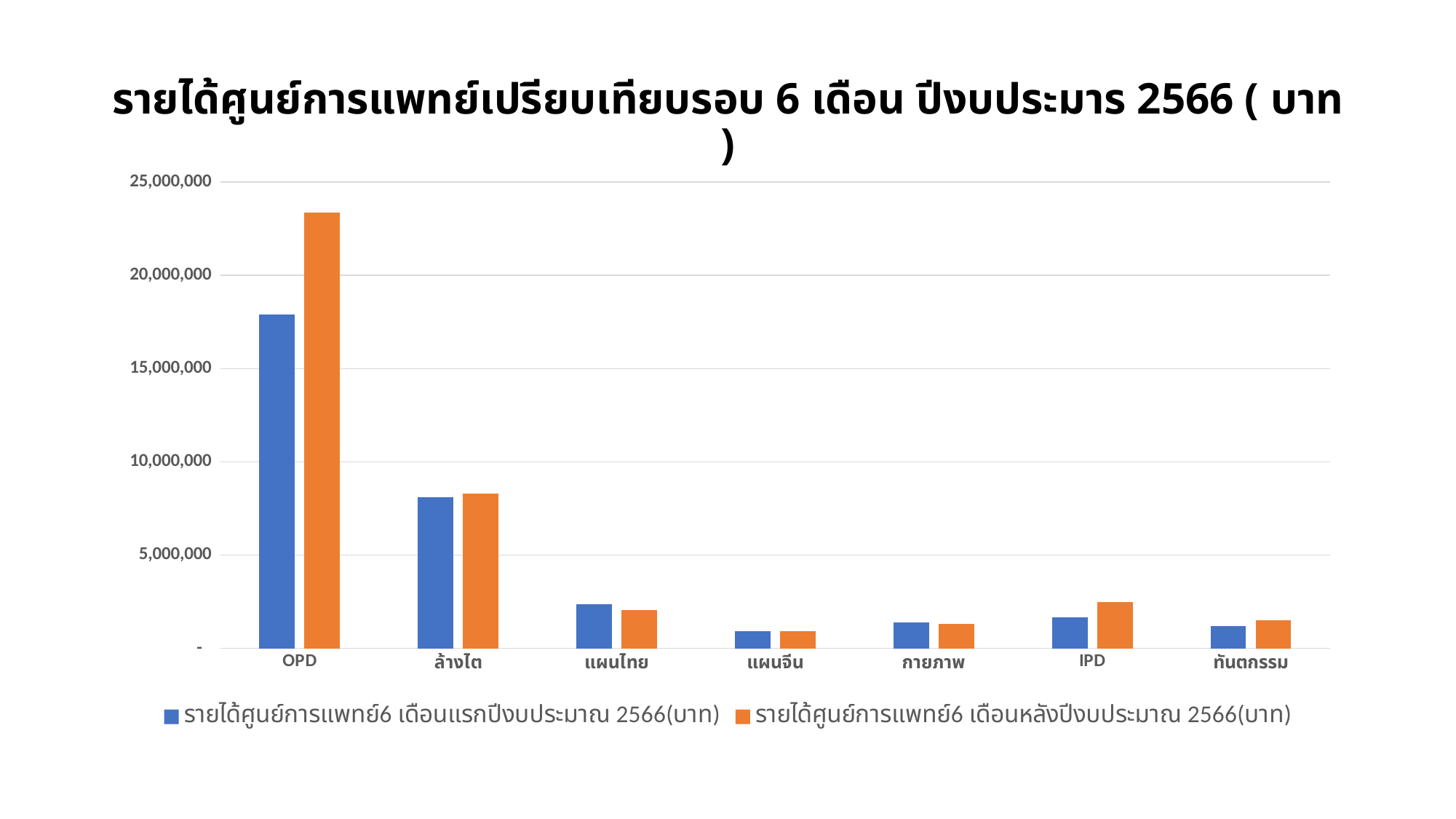
What kind of chart is shown on the slide? bar chart How many series does the legend list? 2 Which category has the lowest value for the series รายได้ศูนย์การแพทย์6 เดือนแรกปีงบประมาณ 2566(บาท)? แผนจีน Which category has the highest value for the series รายได้ศูนย์การแพทย์6 เดือนแรกปีงบประมาณ 2566(บาท)? OPD For IPD, which series has the larger value: รายได้ศูนย์การแพทย์6 เดือนแรกปีงบประมาณ 2566(บาท) or รายได้ศูนย์การแพทย์6 เดือนหลังปีงบประมาณ 2566(บาท)? รายได้ศูนย์การแพทย์6 เดือนหลังปีงบประมาณ 2566(บาท) Is the value for OPD in the series รายได้ศูนย์การแพทย์6 เดือนหลังปีงบประมาณ 2566(บาท) greater or less than 20,000,000? greater For OPD, which series has the larger value: รายได้ศูนย์การแพทย์6 เดือนแรกปีงบประมาณ 2566(บาท) or รายได้ศูนย์การแพทย์6 เดือนหลังปีงบประมาณ 2566(บาท)? รายได้ศูนย์การแพทย์6 เดือนหลังปีงบประมาณ 2566(บาท) How many categories are shown along the x axis? 7 Which colour represents the series รายได้ศูนย์การแพทย์6 เดือนหลังปีงบประมาณ 2566(บาท) in the legend? orange Which category has the highest value for the series รายได้ศูนย์การแพทย์6 เดือนหลังปีงบประมาณ 2566(บาท)? OPD Is the value for ล้างไต in the series รายได้ศูนย์การแพทย์6 เดือนแรกปีงบประมาณ 2566(บาท) greater or less than 5,000,000? greater Is the value for OPD in the series รายได้ศูนย์การแพทย์6 เดือนแรกปีงบประมาณ 2566(บาท) greater or less than 20,000,000? less